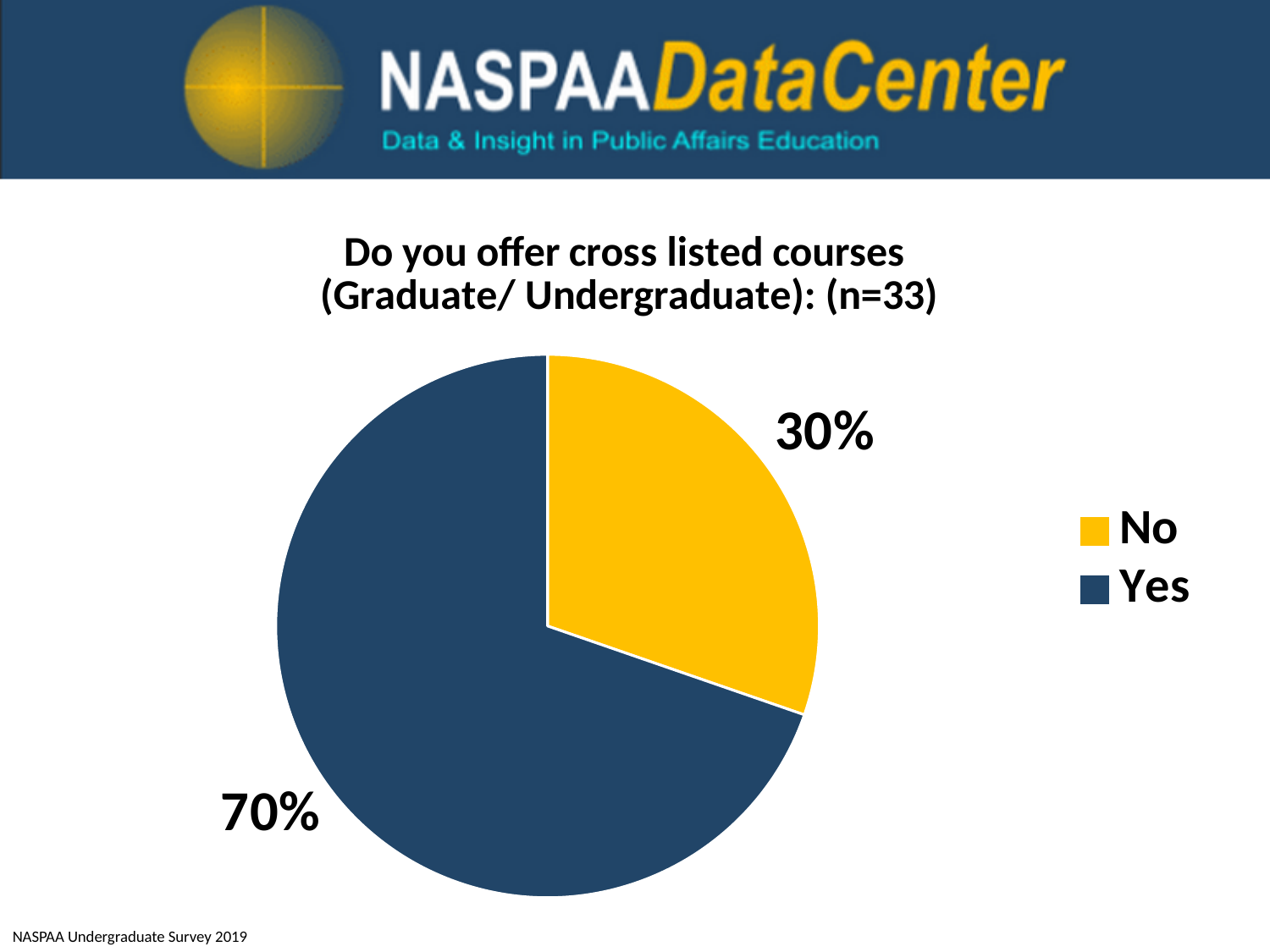
How many entries does the legend list? 2 Which slice of the pie is the largest? Yes What colour is the "No" slice in the pie chart? yellow What is the title of the chart? Do you offer cross listed courses (Graduate/ Undergraduate): (n=33) What kind of chart is shown on the slide? pie chart What is the total of the two slice percentages shown on the pie chart? 100% What share of the pie is labelled "No"? 30% Which is larger, the "Yes" slice or the "No" slice? Yes How many slices does the pie chart have? 2 What share of the pie is labelled "Yes"? 70% Which slice of the pie is the smallest? No What is the difference in percentage points between the "Yes" and "No" slices? 40